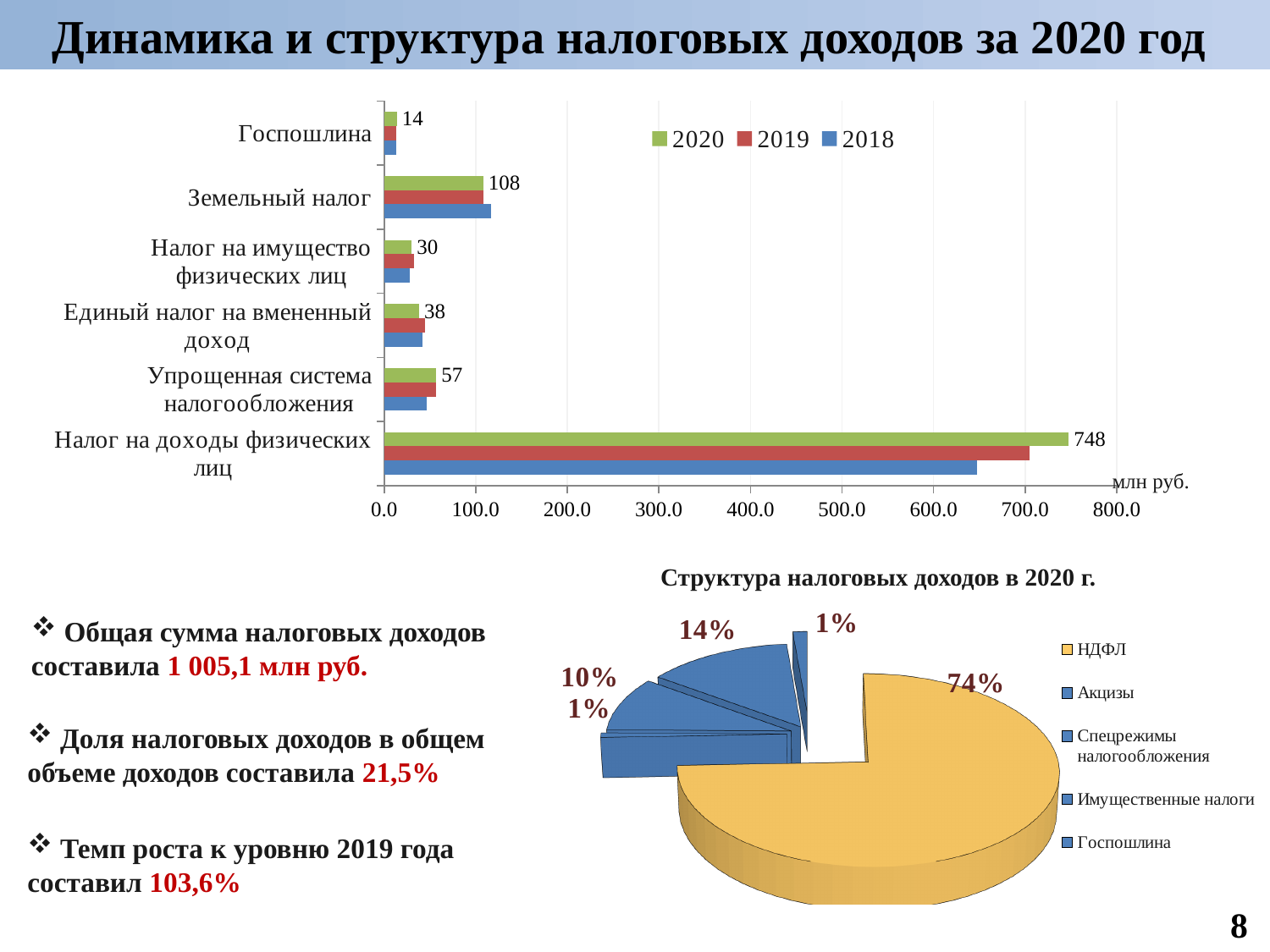
What kind of chart is the chart titled Структура налоговых доходов в 2020 г.? pie chart In the top bar chart, what is the 2020 value for Налог на доходы физических лиц? 748 In the top bar chart, which category has the lowest 2020 value? Госпошлина In the top bar chart, which category has the highest 2020 value? Налог на доходы физических лиц How many categories are shown in the top bar chart? 6 In the top bar chart, is the 2018 value for Налог на доходы физических лиц greater or less than 700.0? less What kind of chart is the top chart on the slide? bar chart In the top bar chart, what is the difference between the 2020 values for Упрощенная система налогообложения and Единый налог на вмененный доход? 19 In the top bar chart, what is the 2020 value for Госпошлина? 14 In the top bar chart, how many series does the legend list? 3 In the top bar chart, what is the 2020 value for Земельный налог? 108 In the pie chart Структура налоговых доходов в 2020 г., what share does НДФЛ have? 74%